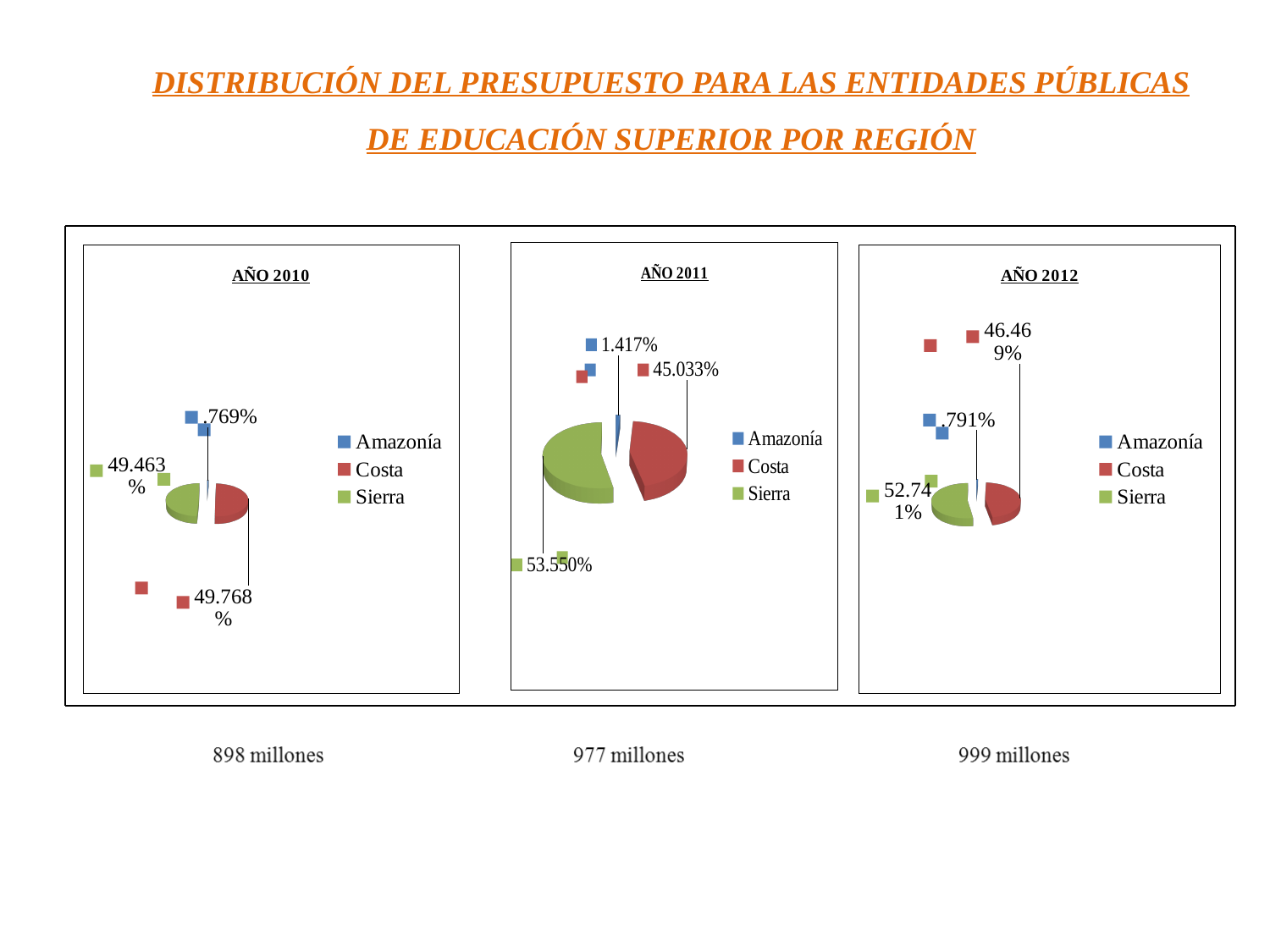
In the AÑO 2011 chart, which region has the largest share? Sierra In the AÑO 2012 chart, what is the value shown for Amazonía? .791% In the AÑO 2011 chart, which is larger, the share for Sierra or the share for Costa? Sierra In the AÑO 2010 chart, what share of the budget goes to Costa? 49.768% In the AÑO 2011 chart, what is the difference between the Sierra share and the Costa share? 8.517% In the AÑO 2012 chart, which region has the smallest share? Amazonía In the AÑO 2010 chart, what is the value shown for Amazonía? .769% In the AÑO 2011 chart, what is the value shown for Costa? 45.033% In the AÑO 2012 chart, what is the difference between the Sierra share and the Costa share? 6.272% How many regions does the legend of the AÑO 2012 chart list? 3 What kind of chart is used for AÑO 2010? Pie chart In the AÑO 2011 chart, what is the value shown for Sierra? 53.550%